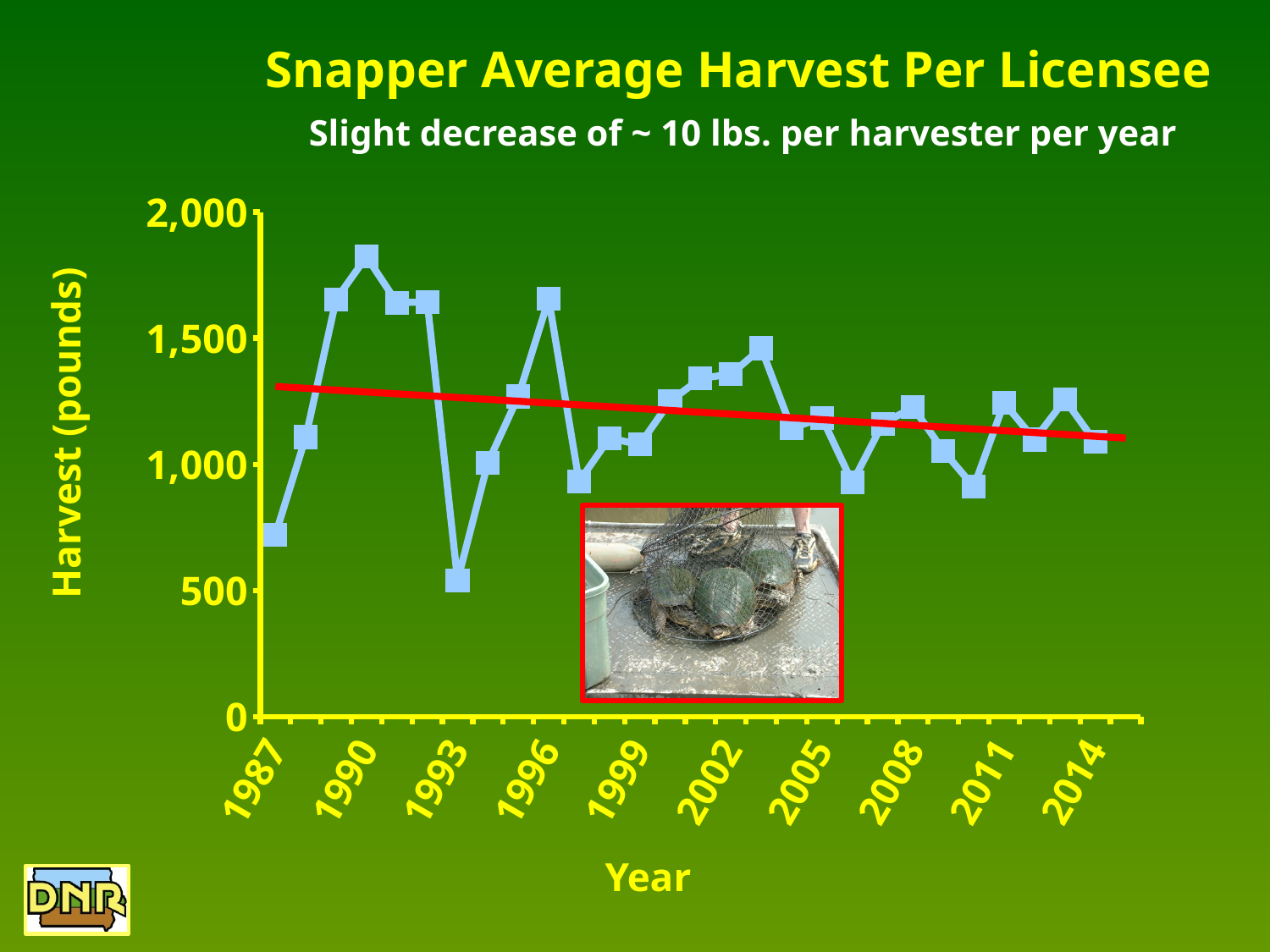
Which year has the highest average harvest per licensee? 1990 Is the value for 2002 greater or less than 1,000? greater Which year has the larger average harvest, 1990 or 1993? 1990 What kind of chart is shown on the slide? line chart What is the title of the chart? Snapper Average Harvest Per Licensee Is the value for 1996 greater or less than 1,500? greater Is the value for 1987 greater or less than 1,000? less Which year has the lowest average harvest per licensee? 1993 What is the label of the vertical axis? Harvest (pounds) According to the red trend line, does the average harvest per licensee rise or fall from 1987 to 2014? fall